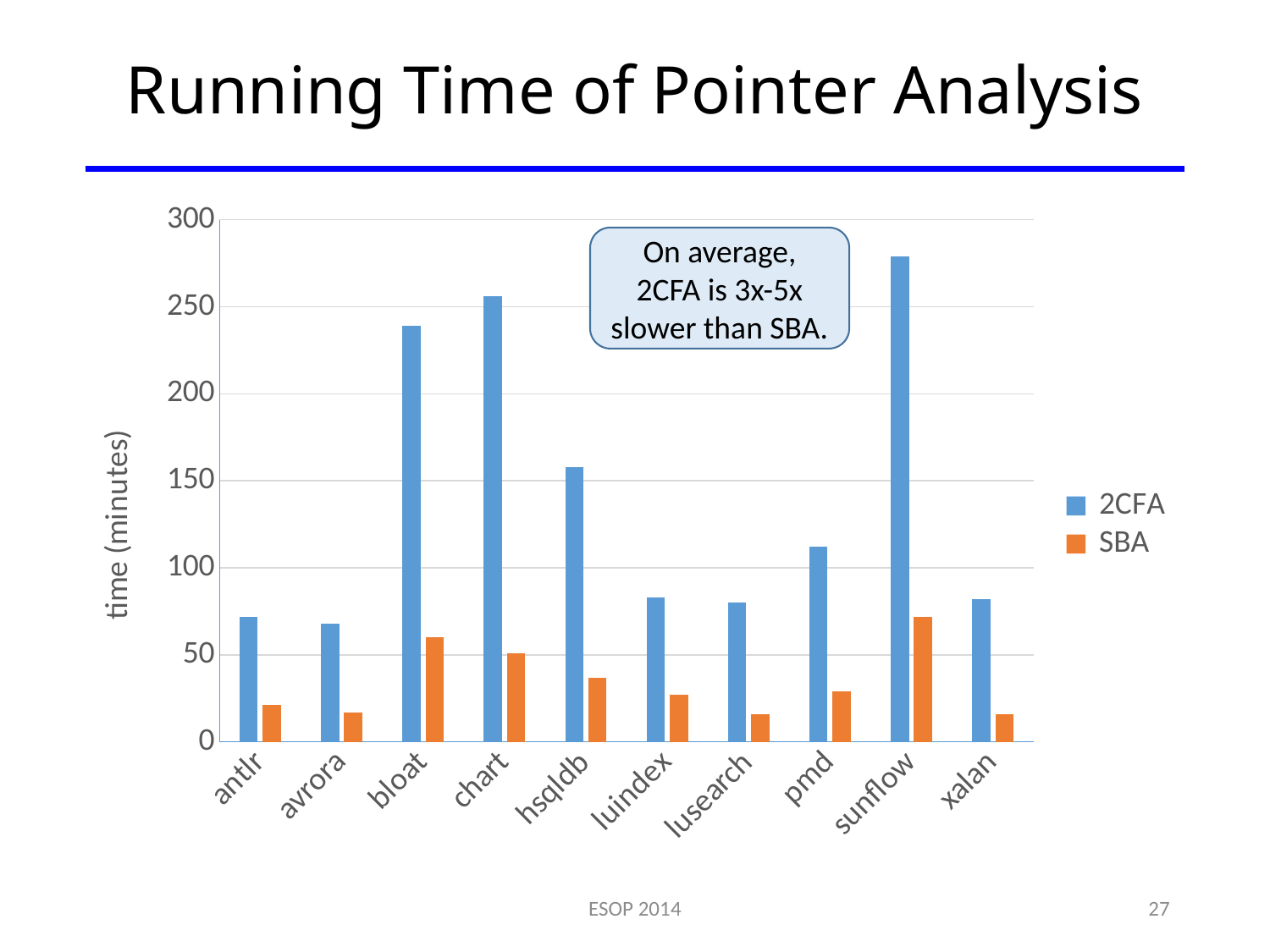
How many series does the legend list? 2 Is the 2CFA value for sunflow greater or less than 250? greater Which is larger, the SBA value for bloat or the SBA value for luindex? bloat What is the label of the y axis? time (minutes) How many benchmark categories are shown on the x axis? 10 Is the 2CFA value for bloat greater or less than 200? greater What kind of chart is shown on the slide? bar chart Which benchmark has the highest 2CFA running time? sunflow Which benchmark has the highest SBA running time? sunflow Is the 2CFA value for pmd greater or less than 100? greater Which is larger, the 2CFA value for hsqldb or the 2CFA value for pmd? hsqldb